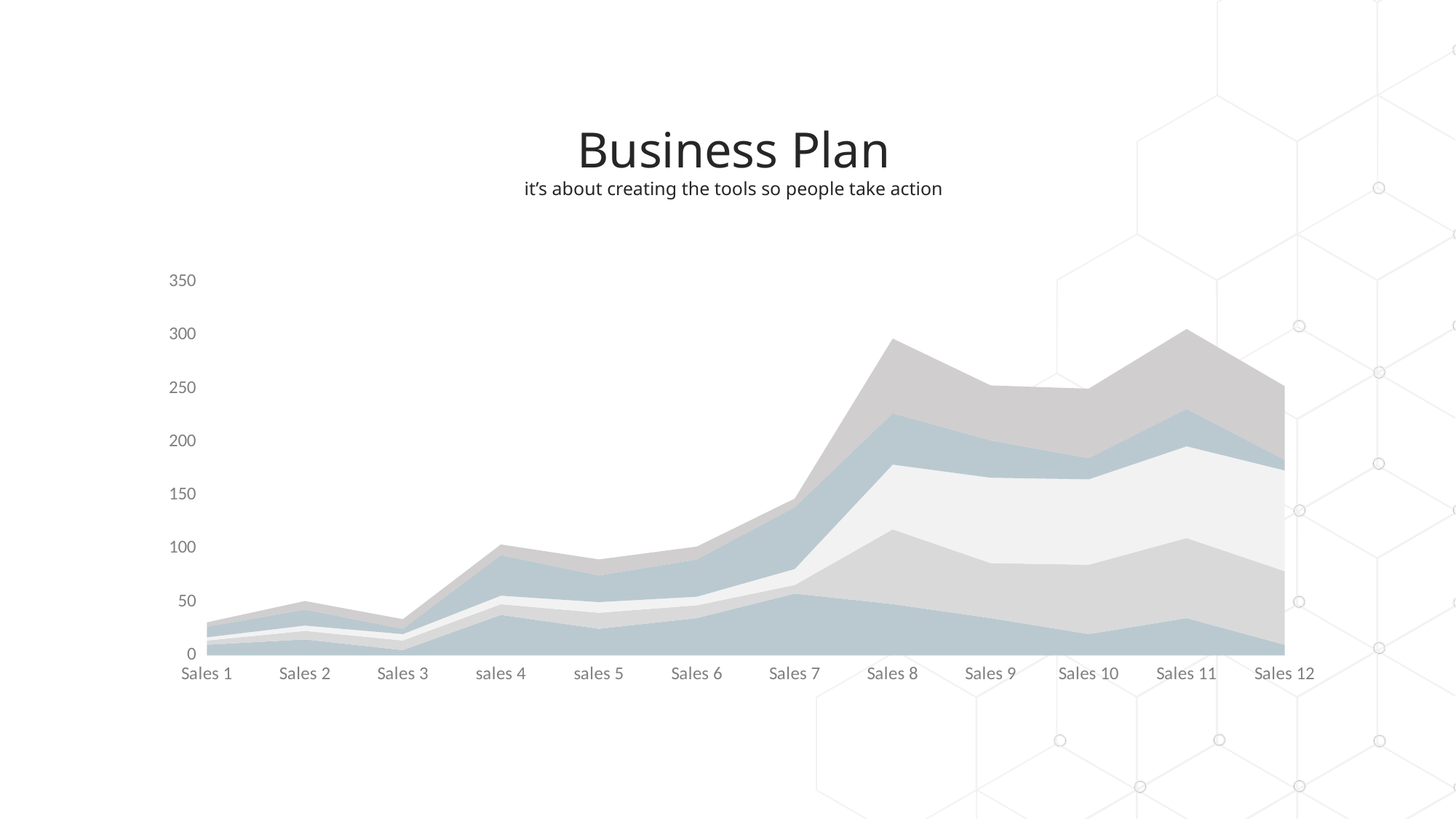
What is the title of the slide containing the chart? Business Plan Is the total stacked value for Sales 8 greater or less than 250? greater What kind of chart is shown on the slide? Stacked area chart Do the total stacked values generally rise or fall from Sales 1 to Sales 12? Rise Which has a larger total stacked value, Sales 7 or Sales 8? Sales 8 Is the total stacked value for Sales 3 greater or less than 50? less Is the total stacked value for Sales 4 greater or less than 50? greater Which has a larger total stacked value, Sales 1 or Sales 12? Sales 12 How many categories are shown along the x axis of the chart? 12 What is the highest value shown on the chart's y axis? 350